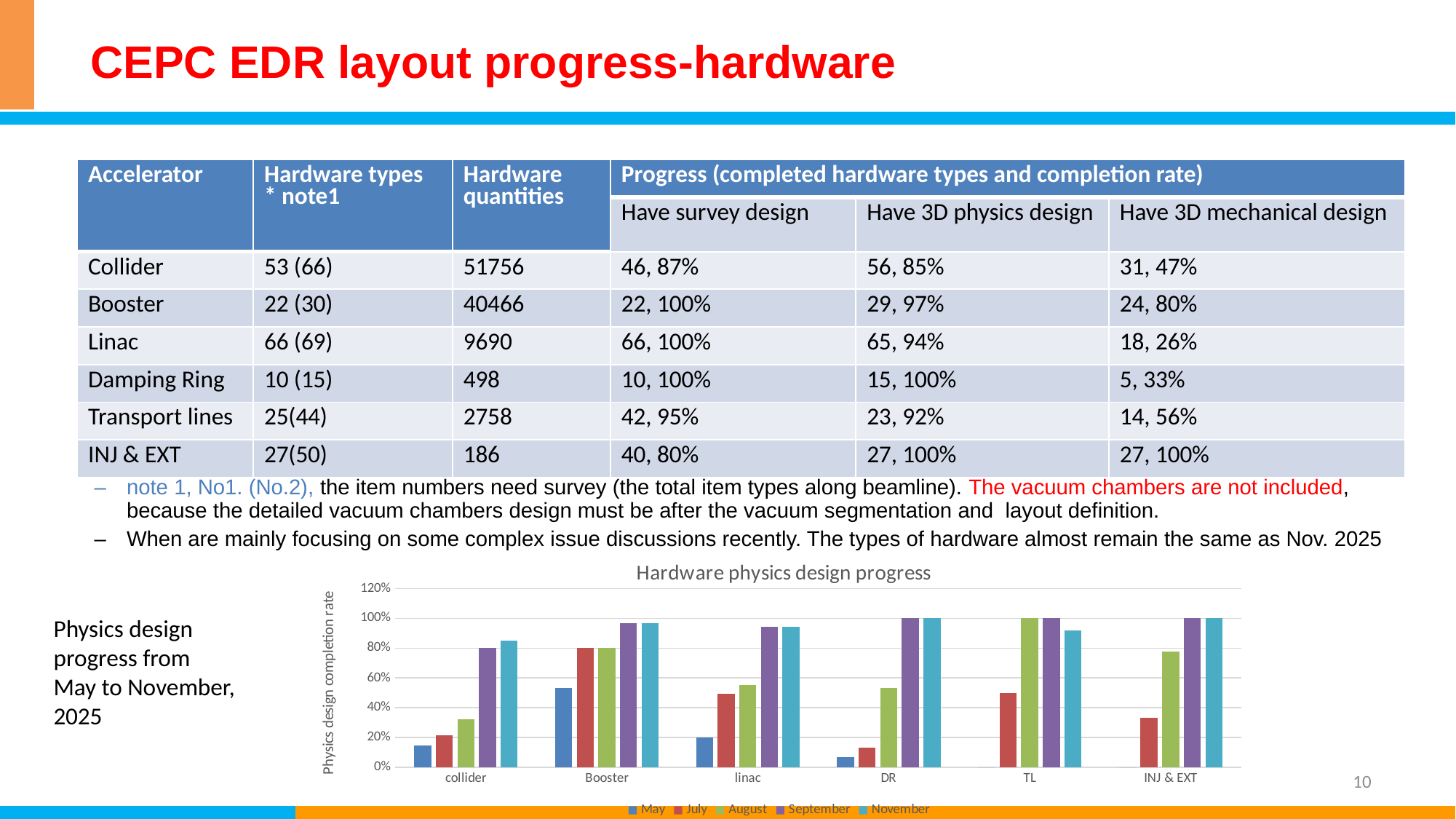
What is the title of the chart? Hardware physics design progress Is the May value for DR greater or less than 20%? less What type of chart is shown on the slide? bar chart Is the May value for collider greater or less than 20%? less Which is larger for the May series: the value for Booster or the value for linac? Booster Is the November value for TL greater or less than 80%? greater How many accelerator categories are shown on the x axis of the chart? 6 What is the label of the vertical axis of the chart? Physics design completion rate Do the collider values rise or fall from May to November? rise How many series does the chart legend list? 5